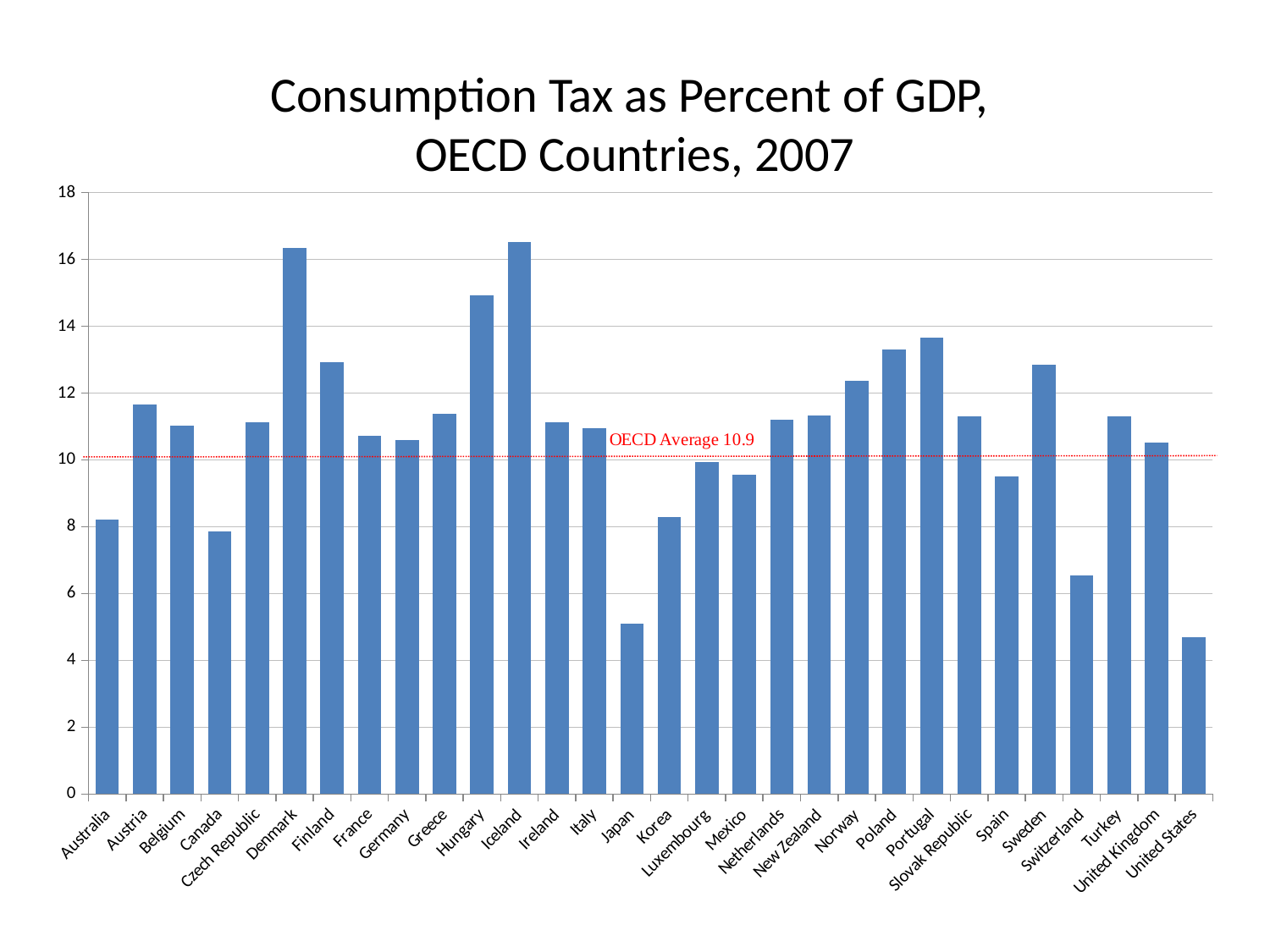
Is the value for Hungary greater or less than 14? greater What is the OECD average consumption tax as a percent of GDP shown on the chart? 10.9 How many countries are plotted on the chart? 30 Is the value for Japan greater or less than 6? less What is the title of the chart? Consumption Tax as Percent of GDP, OECD Countries, 2007 Is the value for Denmark greater or less than 16? greater Which has a higher consumption tax as a percent of GDP, Japan or Korea? Korea Which has a higher consumption tax as a percent of GDP, Denmark or Finland? Denmark What kind of chart is shown on the slide? bar chart Which country has the lowest consumption tax as a percent of GDP? United States